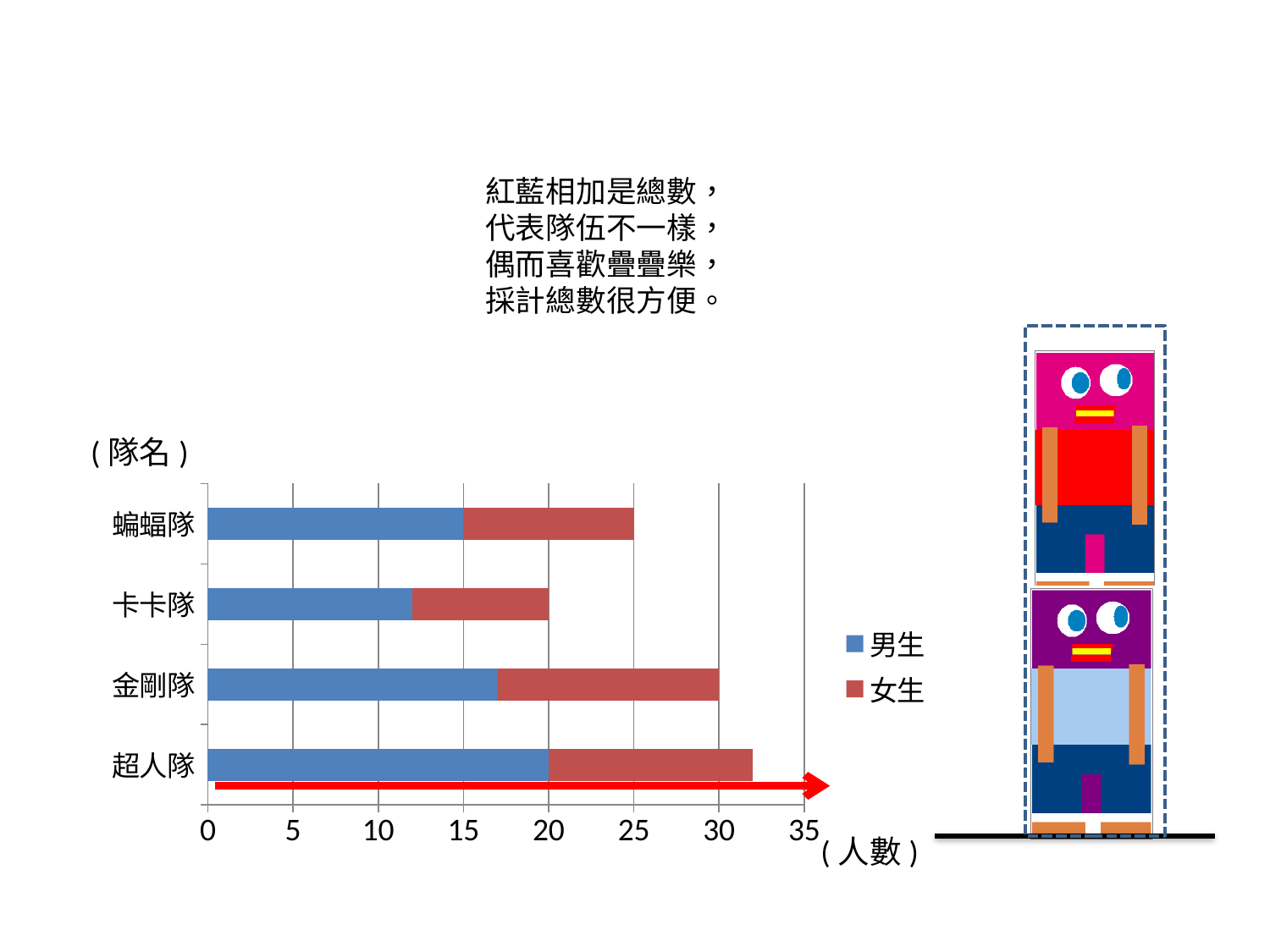
Which team has the smallest total number of people? 卡卡隊 What is the total (男生 plus 女生) for 金剛隊? 30 What is the total (男生 plus 女生) for 卡卡隊? 20 What is the 男生 value for 超人隊? 20 How many teams (categories) are shown on the chart? 4 Which team has more 男生, 超人隊 or 卡卡隊? 超人隊 What are the two series listed in the legend? 男生, 女生 What kind of chart is shown on the slide? bar chart What is the 男生 value for 蝙蝠隊? 15 How many series does the legend list? 2 What is the total (男生 plus 女生) for 蝙蝠隊? 25 Is the total for 超人隊 greater or less than 30? greater